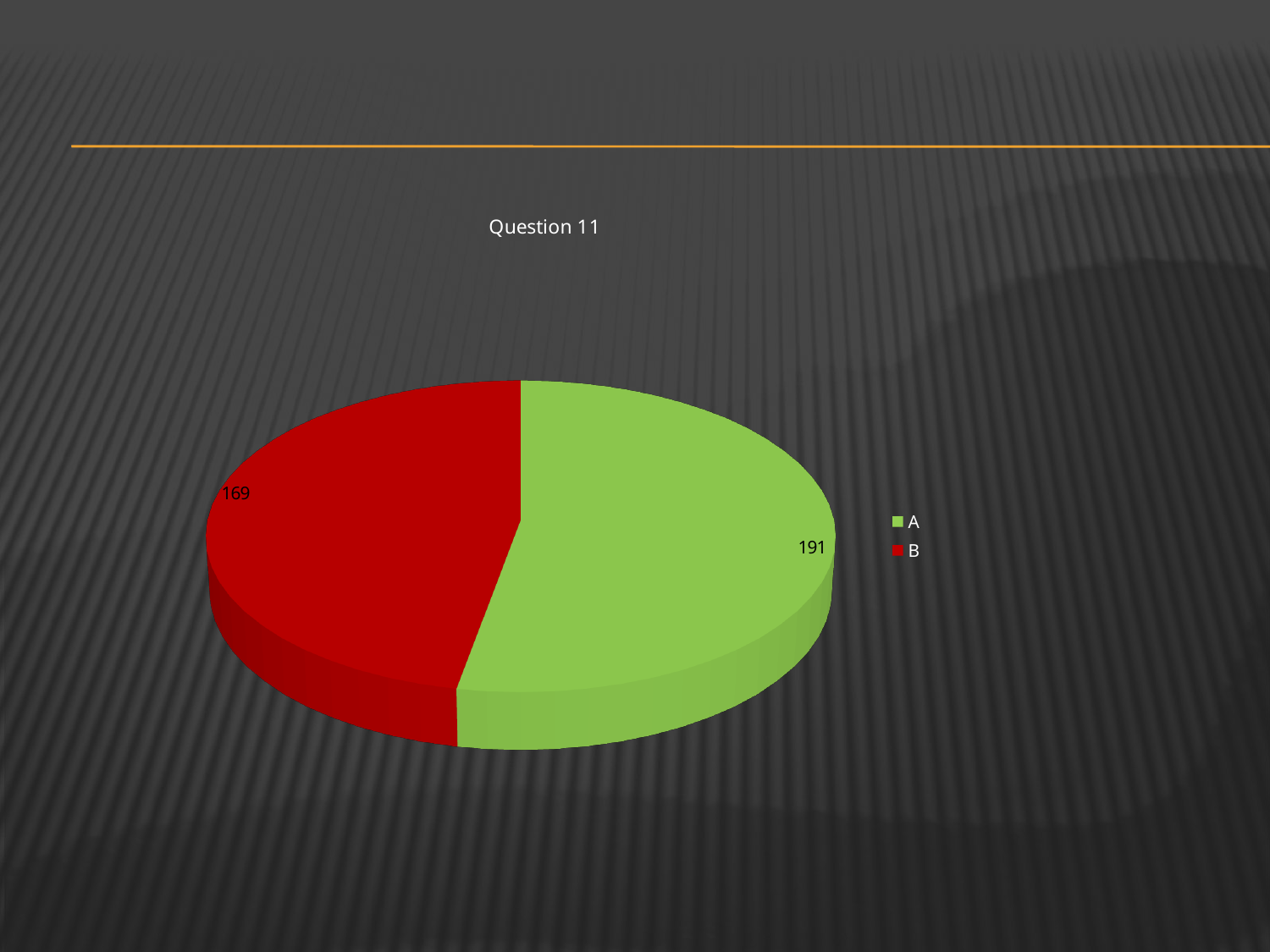
What kind of chart is shown on the slide? Pie chart What is the value for B in the pie chart? 169 Which category has the smallest slice in the pie chart? B What is the title of the chart? Question 11 Which is larger, the value for A or the value for B? A What colour is the slice for B? Red How many slices does the pie chart have? 2 What is the difference between the values for A and B? 22 What is the value for A in the pie chart? 191 What is the total of all slices in the pie chart? 360 Which category has the largest slice in the pie chart? A How many entries does the legend list? 2